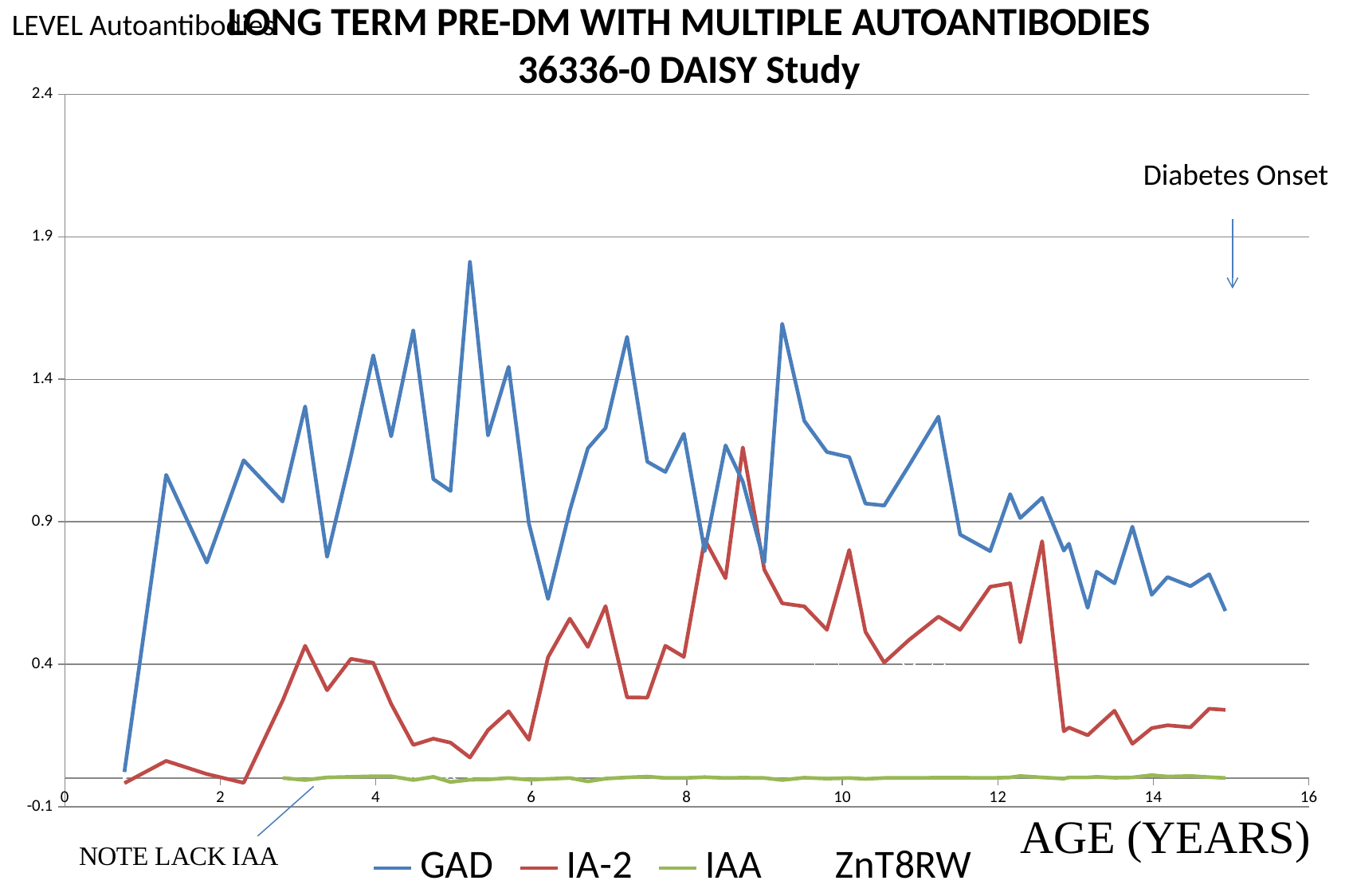
Which series reaches the highest value on the chart? GAD Is the peak value of the GAD line greater or less than 1.4? greater Which of the plotted lines stays lowest across the whole age range, GAD, IA-2 or IAA? IAA Is the highest value of the IA-2 line greater or less than 0.9? greater Is the peak value of the GAD line greater or less than 1.9? less Does the IA-2 line rise or fall sharply just after age 12.5? fall What kind of chart is shown on the slide? line chart How many series does the legend list? 4 What is the label on the x axis? AGE (YEARS) Around age 5, which series has the larger value, GAD or IA-2? GAD